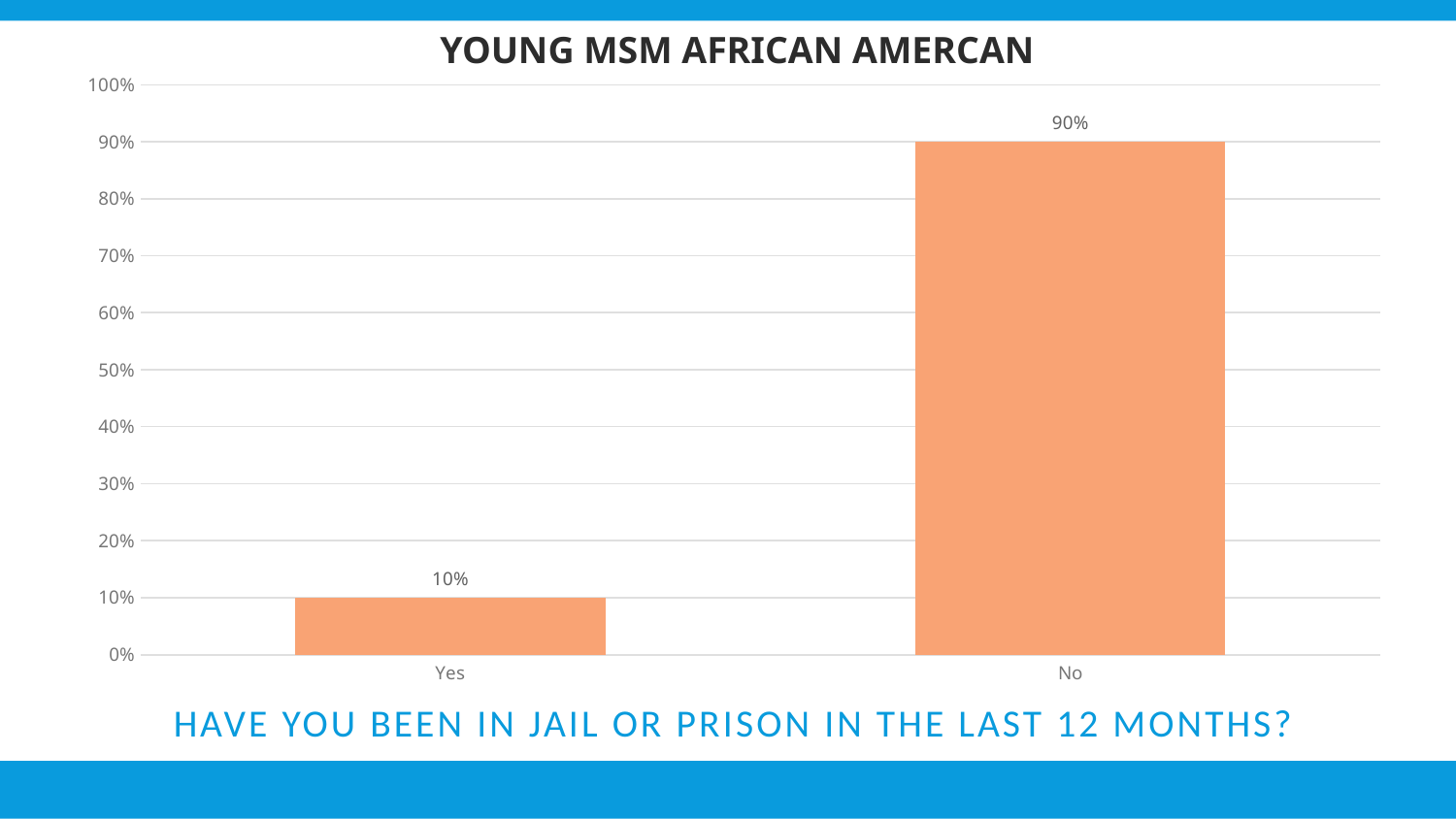
What is the value for "Yes"? 10% How many categories are shown on the x axis? 2 What is the highest value shown on the y axis? 100% Is the value for "Yes" greater or less than 20%? less What is the title of the chart? YOUNG MSM AFRICAN AMERCAN What kind of chart is shown on the slide? bar chart What is the difference between the values for "No" and "Yes"? 80% Which category has the lowest value? Yes What is the value for "No"? 90% Which category has the highest value? No Which is larger, the value for "Yes" or the value for "No"? No Is the value for "No" greater or less than 50%? greater